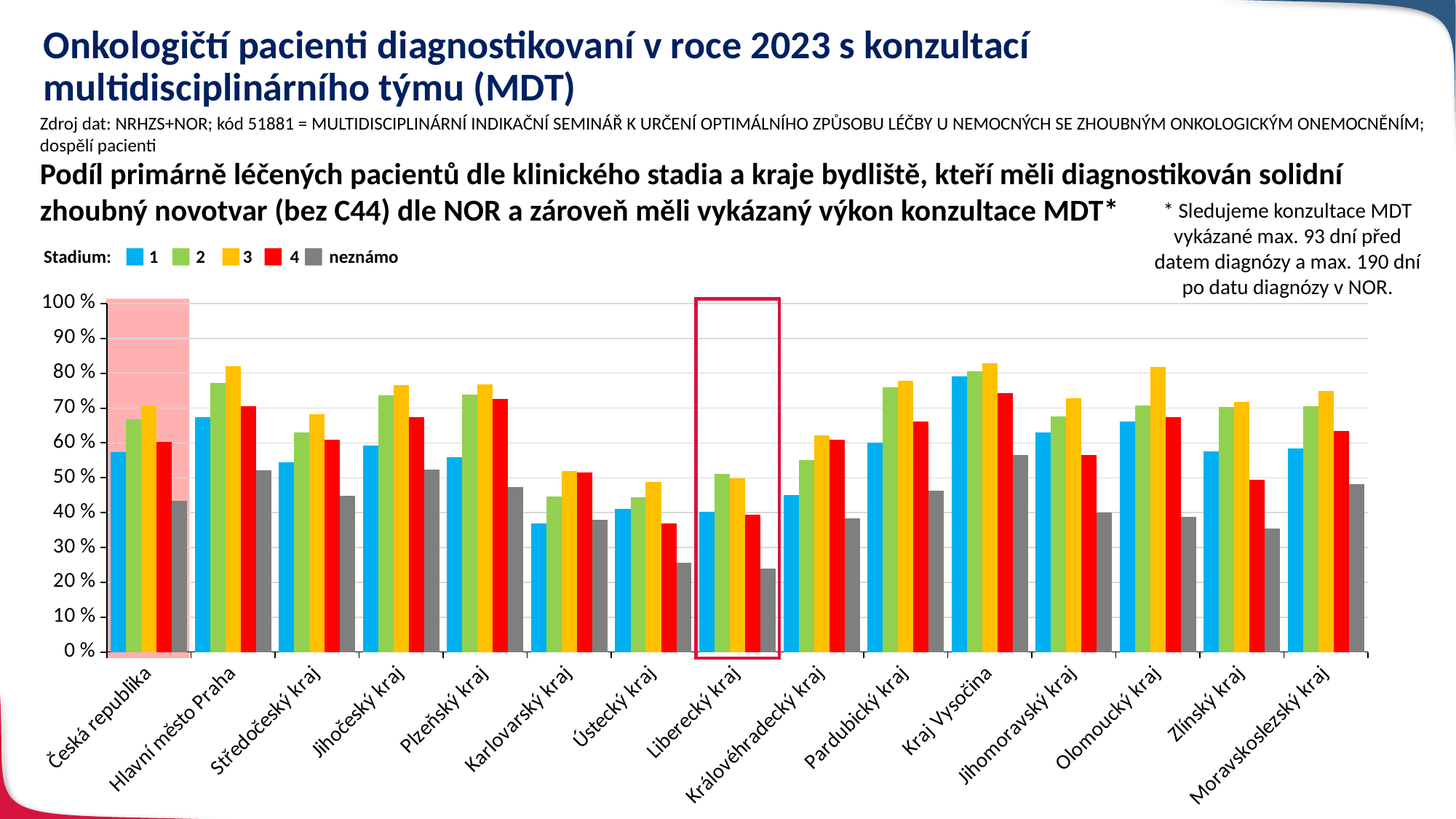
Which region has the highest value for the 'neznámo' series? Kraj Vysočina Is the value for stadium 1 in Kraj Vysočina greater or less than 70 %? greater Is the value for 'neznámo' in Liberecký kraj greater or less than 30 %? less How many series does the legend list? 5 Is the value for stadium 4 in Ústecký kraj greater or less than 40 %? less What kind of chart is shown on the slide? bar chart Which region has the highest value for stadium 1? Kraj Vysočina How many regions (categories) are shown on the x axis, including Česká republika? 15 Which region has the lowest value for stadium 1? Karlovarský kraj For Česká republika, which is larger: the value for stadium 1 or the value for stadium 3? stadium 3 Which region is outlined with a red rectangle on the chart? Liberecký kraj